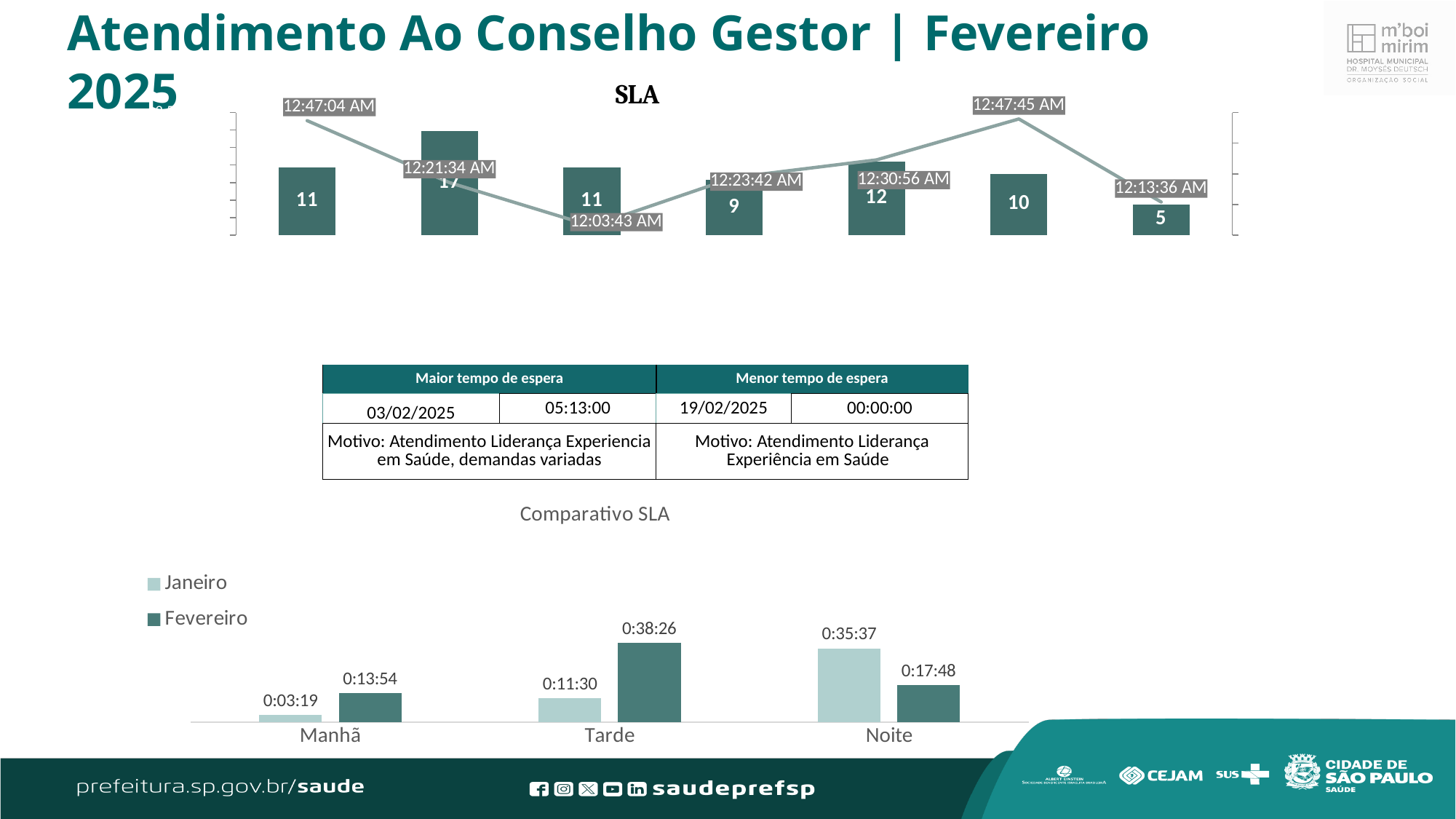
What kind of chart is the bottom chart titled 'Comparativo SLA'? Bar chart In the bottom chart titled 'Comparativo SLA', for Noite, which series has the larger value, Janeiro or Fevereiro? Janeiro In the bottom chart titled 'Comparativo SLA', how many categories are shown on the x axis? 3 In the bottom chart titled 'Comparativo SLA', what is the Janeiro value for Manhã? 0:03:19 In the bottom chart titled 'Comparativo SLA', which category has the lowest Janeiro value? Manhã In the bottom chart titled 'Comparativo SLA', which category has the highest Fevereiro value? Tarde In the bottom chart titled 'Comparativo SLA', how many series does the legend list? 2 In the top chart titled 'SLA', what is the highest value printed on a bar? 17 In the top chart titled 'SLA', how many bars are plotted? 7 In the bottom chart titled 'Comparativo SLA', what is the Fevereiro value for Tarde? 0:38:26 In the bottom chart titled 'Comparativo SLA', what is the Janeiro value for Noite? 0:35:37 In the bottom chart titled 'Comparativo SLA', what is the Fevereiro value for Noite? 0:17:48